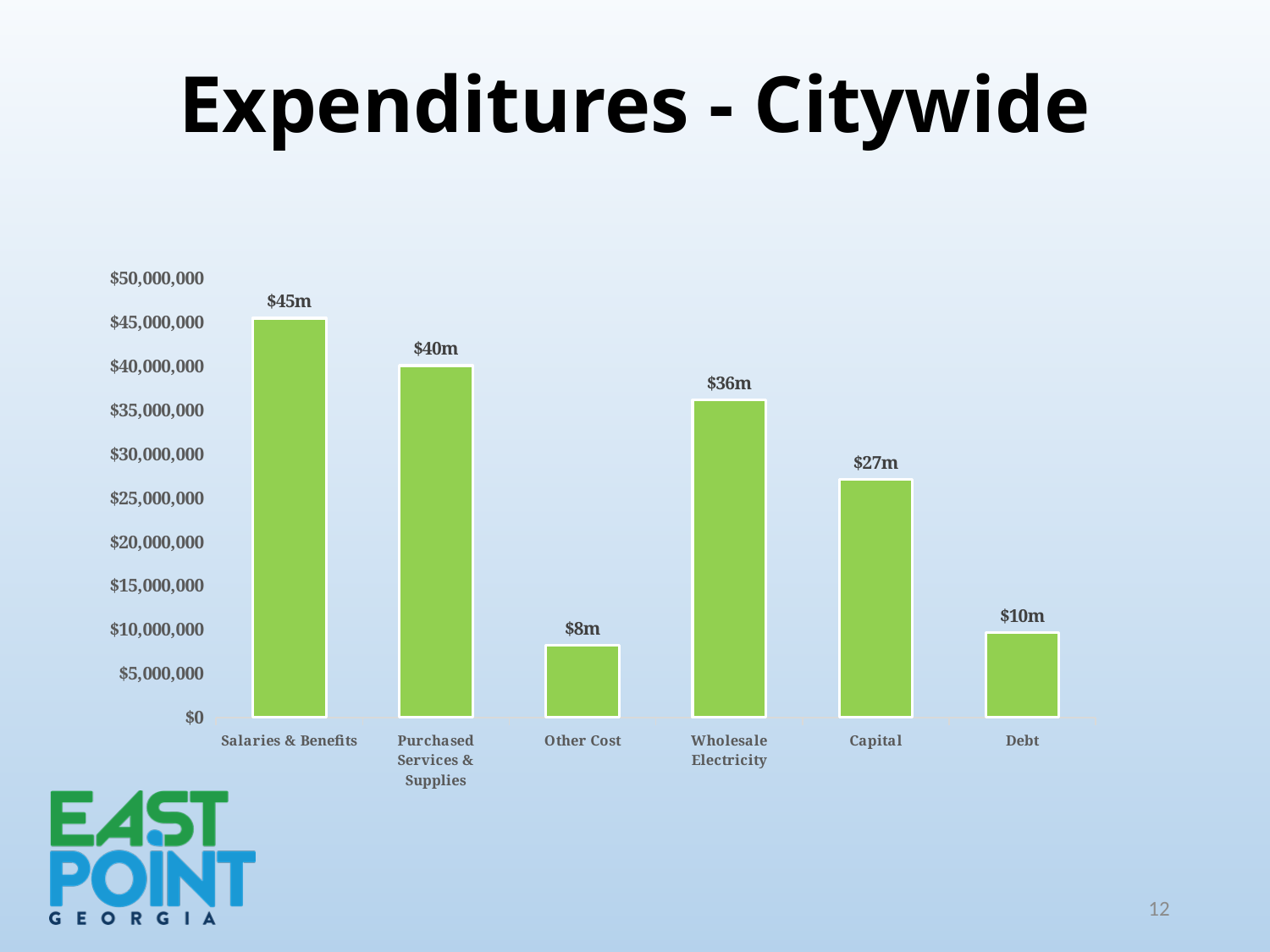
What is the value for Salaries & Benefits? $45m What kind of chart is shown on the slide? bar chart Is the value for Capital greater or less than $30,000,000? less What is the title of the slide? Expenditures - Citywide Which category has the lowest expenditure? Other Cost What is the value for Debt? $10m What is the value for Wholesale Electricity? $36m What is the difference between Purchased Services & Supplies and Capital? $13m How many categories are shown in the chart? 6 What colour are the bars in the chart? green Which is larger, Wholesale Electricity or Capital? Wholesale Electricity Which category has the highest expenditure? Salaries & Benefits